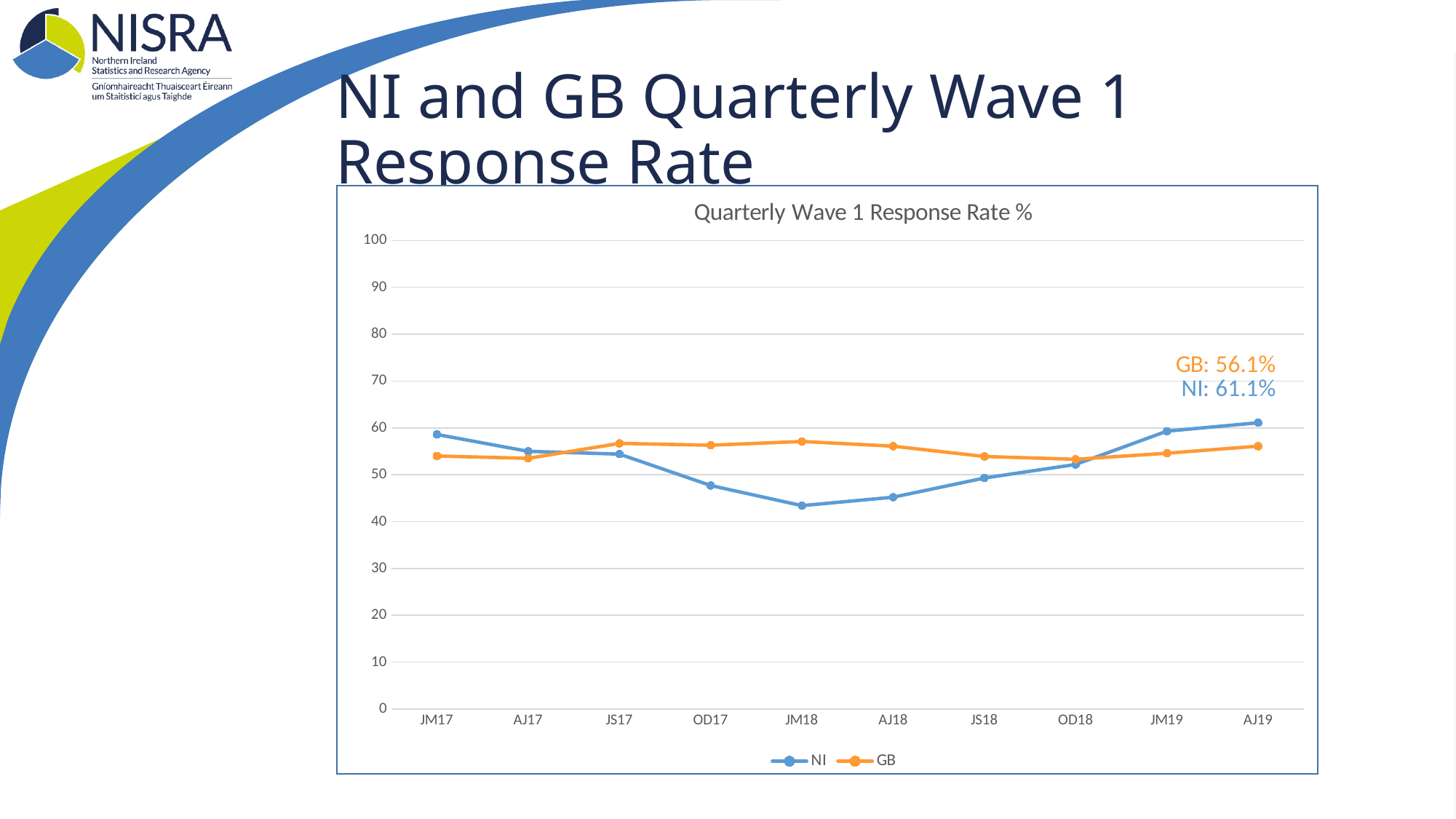
What is the difference between the NI and GB response rates at AJ19? 5.0% Is the NI value for JM18 greater or less than 50? less What is the GB response rate for AJ19? 56.1% Is the GB value for JM18 greater or less than 50? greater How many series does the legend list? 2 In which quarter is the NI response rate highest? AJ19 How many quarters are shown on the x axis? 10 At AJ19, which series has the higher response rate, NI or GB? NI In which quarter is the NI response rate lowest? JM18 What kind of chart is shown on the slide? Line chart At JM18, which series has the higher response rate, NI or GB? GB What is the NI response rate for AJ19? 61.1%